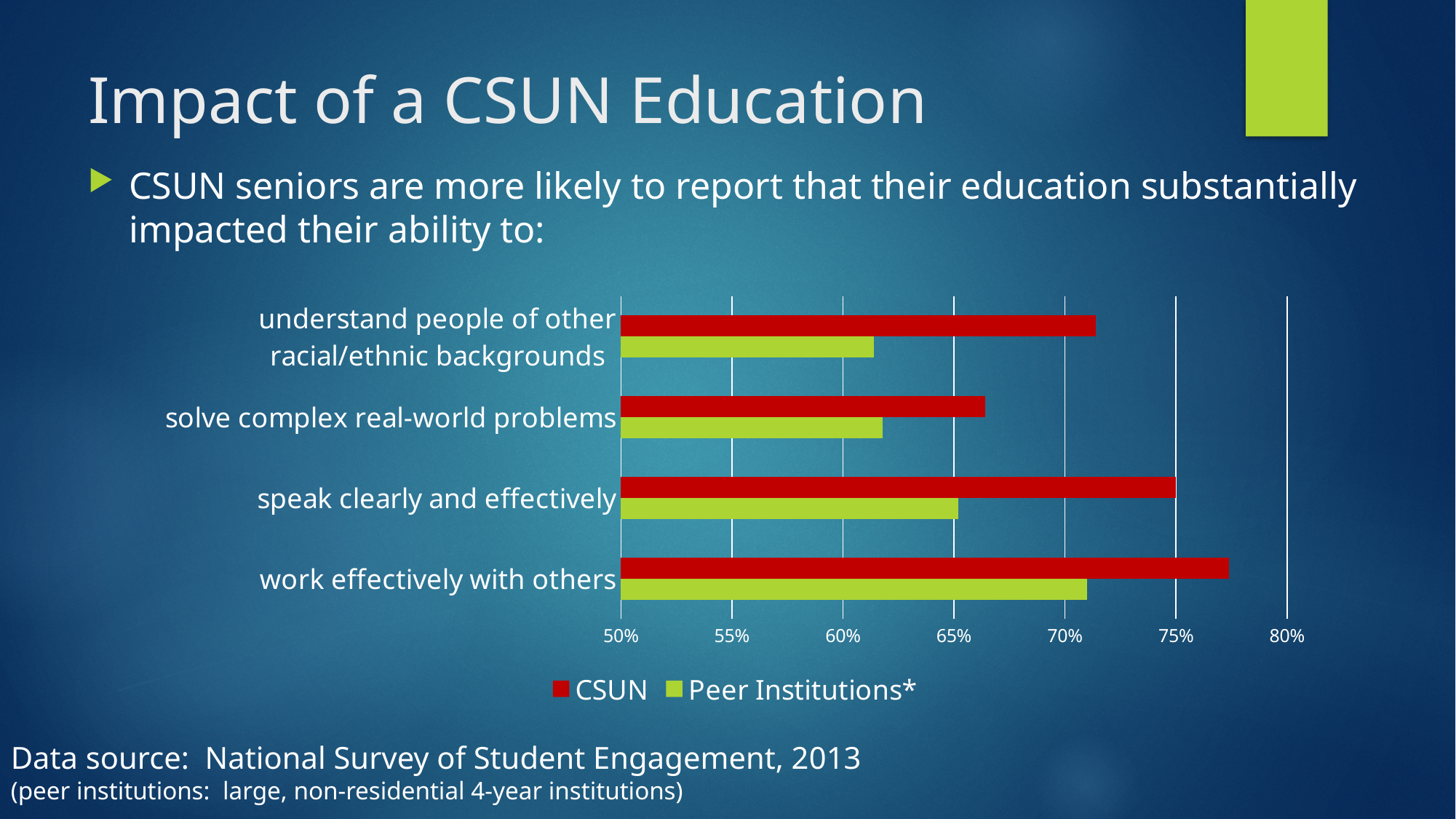
How many series does the chart's legend list? 2 Is the CSUN value for 'work effectively with others' greater or less than 75%? greater Which category has the highest CSUN value? work effectively with others What kind of chart is shown on the slide? bar chart Which category has the highest Peer Institutions* value? work effectively with others For 'solve complex real-world problems', which series has the larger value, CSUN or Peer Institutions*? CSUN Is the CSUN value for 'understand people of other racial/ethnic backgrounds' greater or less than 70%? greater For 'speak clearly and effectively', which series has the larger value, CSUN or Peer Institutions*? CSUN Which category has the lowest CSUN value? solve complex real-world problems How many categories are plotted on the chart? 4 What colour are the CSUN bars in the chart? red Is the Peer Institutions* value for 'understand people of other racial/ethnic backgrounds' greater or less than 65%? less